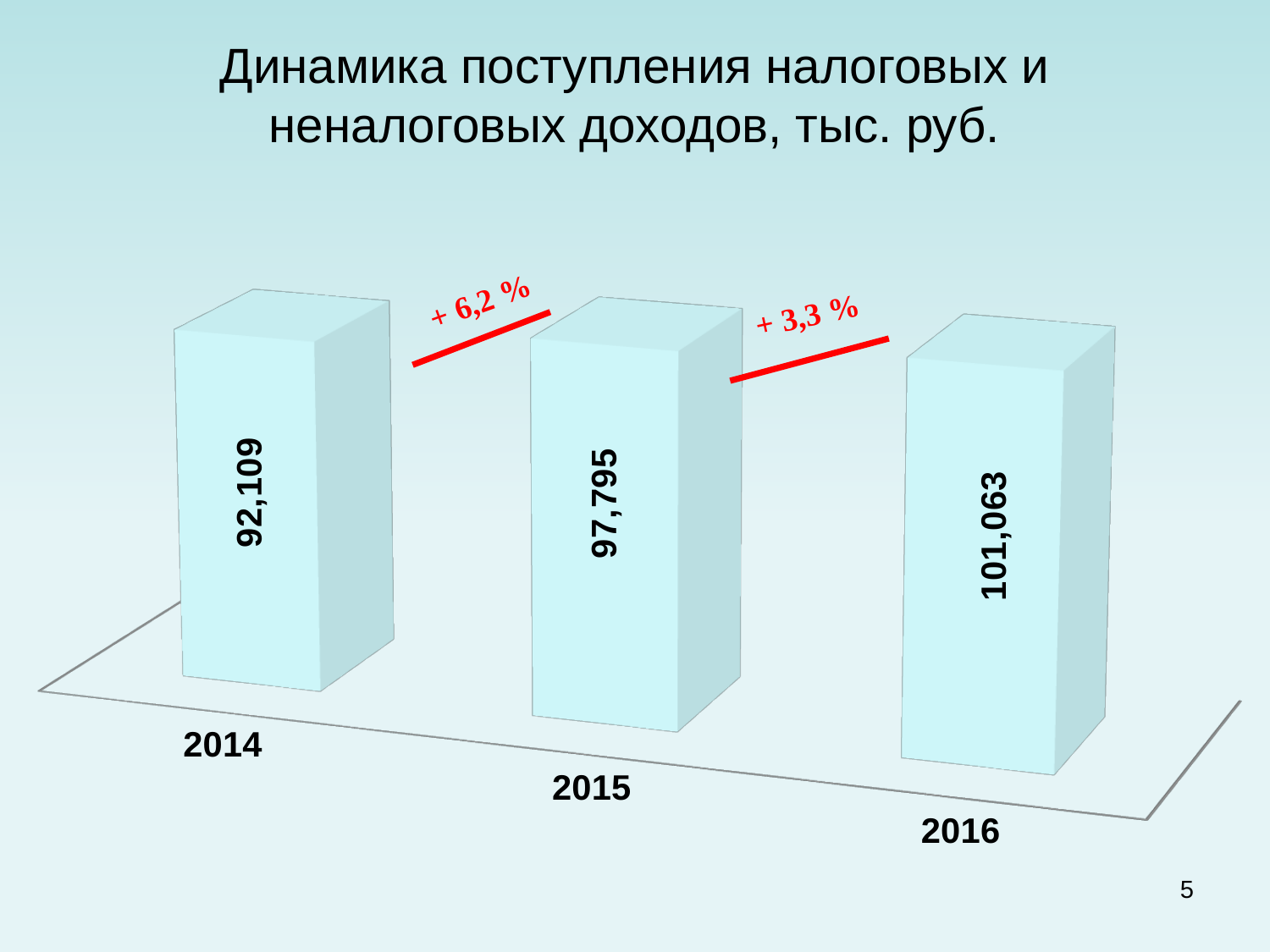
What kind of chart is shown on the slide? Bar chart Do the values rise or fall from 2014 to 2016? Rise How many years are shown in the chart? 3 What is the difference between the values for 2016 and 2015? 3,268 What is the value for 2015? 97,795 Which year has the lowest value? 2014 What percentage change is annotated between 2014 and 2015? + 6,2 % Which year has the highest value? 2016 What is the value for 2014? 92,109 What is the difference between the values for 2015 and 2014? 5,686 What is the value for 2016? 101,063 Which is larger, the value for 2014 or the value for 2016? 2016